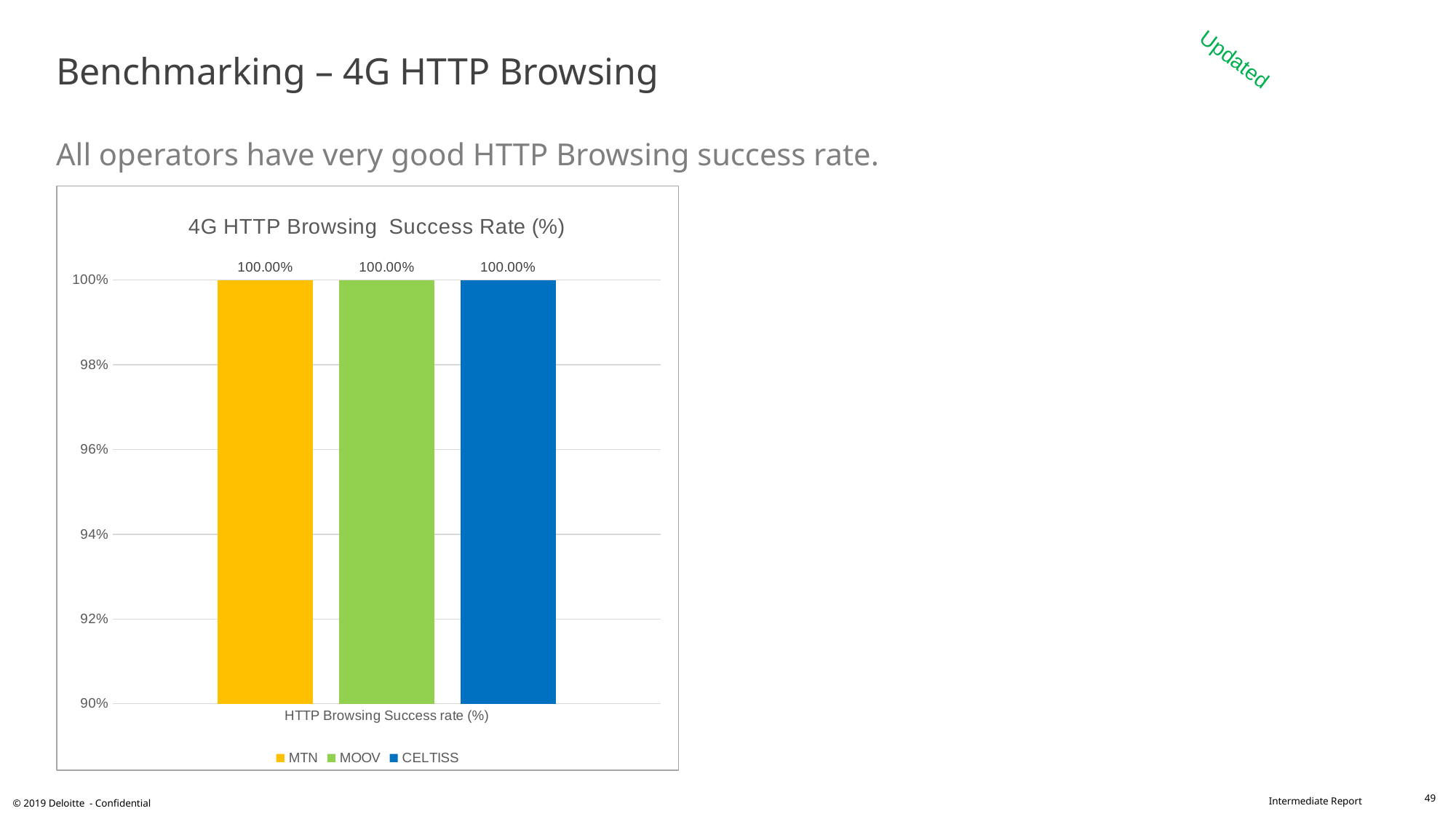
What kind of chart is shown on the slide? Bar chart What is the 4G HTTP Browsing success rate for MTN? 100.00% Which colour represents CELTISS in the chart? Blue Is the value for MOOV greater or less than 98%? greater What is the 4G HTTP Browsing success rate for CELTISS? 100.00% What is the title of the chart? 4G HTTP Browsing Success Rate (%) What is the difference between the success rates of MTN and CELTISS? 0.00% How many series does the legend list? 3 How many bars are plotted in the chart? 3 What is the 4G HTTP Browsing success rate for MOOV? 100.00%